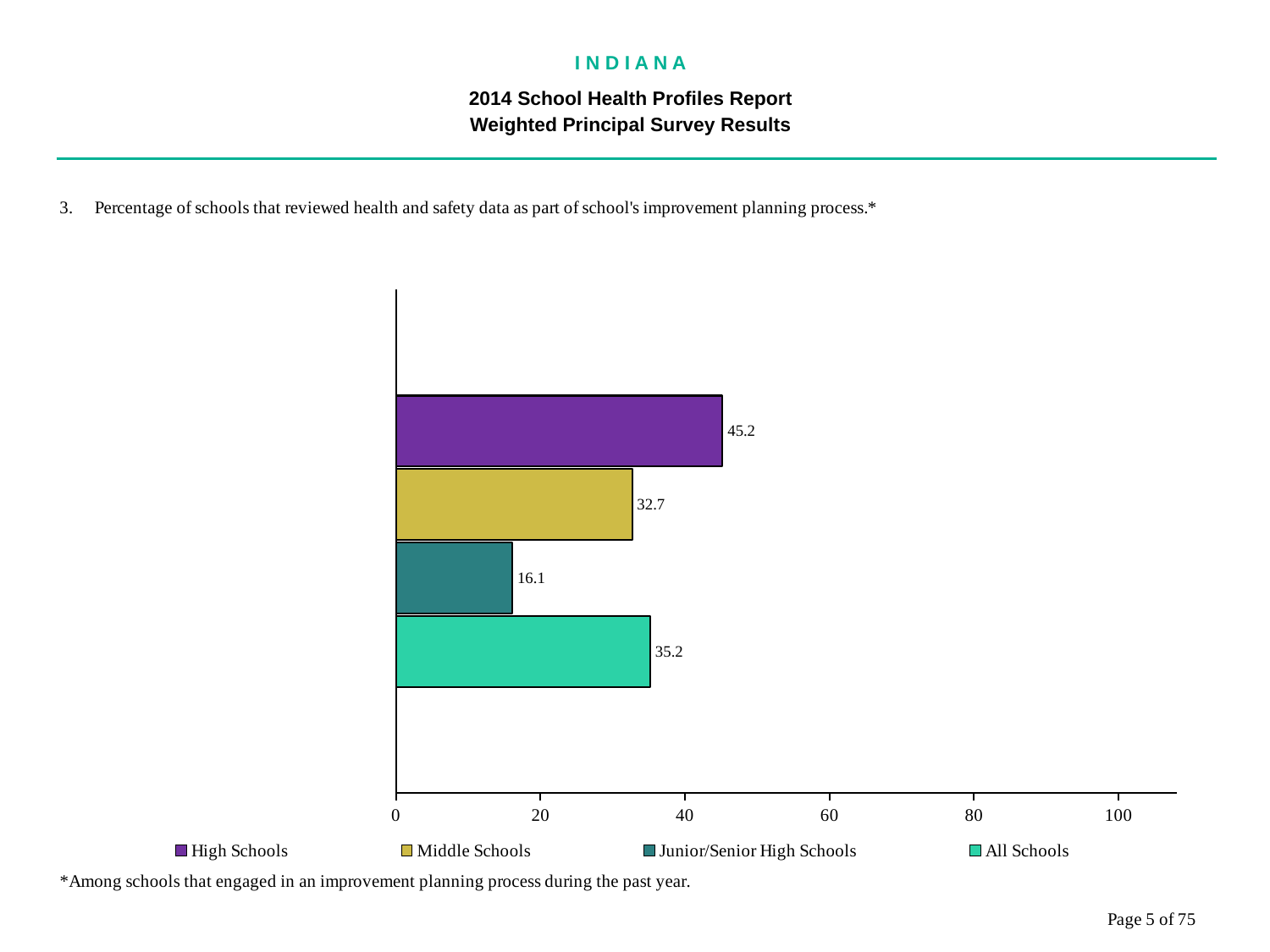
What is the value for Middle Schools? 32.7 Is the value for High Schools greater or less than 40? greater How many series does the legend list? 4 Which school type has the lowest value? Junior/Senior High Schools Which is larger, the value for Middle Schools or the value for All Schools? All Schools What is the difference between the values for High Schools and Middle Schools? 12.5 What is the value for High Schools? 45.2 Which school type has the highest value? High Schools What is the difference between the values for All Schools and Junior/Senior High Schools? 19.1 What kind of chart is shown on the slide? bar chart What is the value for All Schools? 35.2 What is the value for Junior/Senior High Schools? 16.1